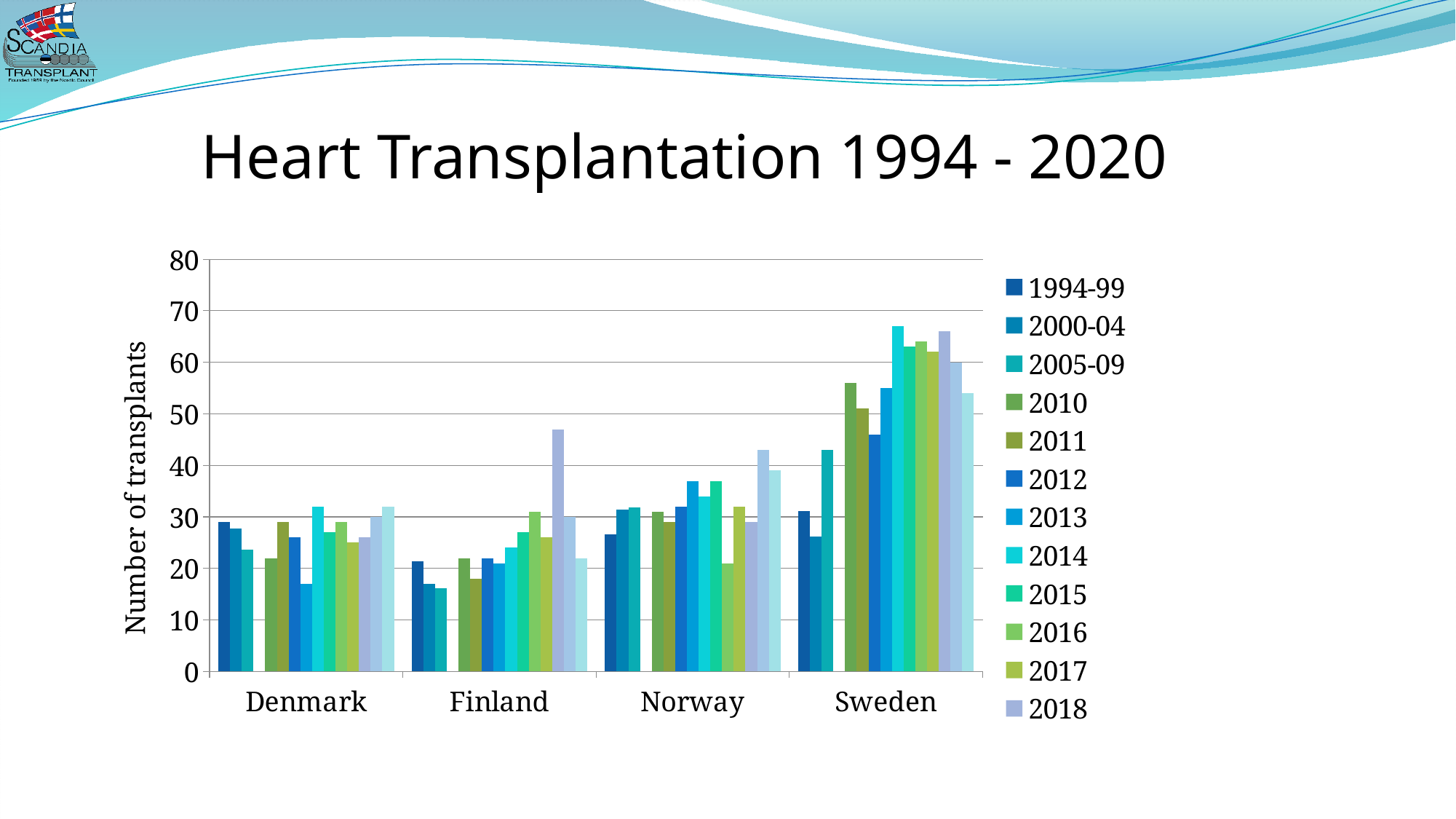
Which country has the lowest bars overall in the chart? Finland Is the value for Denmark in 2012 greater or less than 20? greater Which is larger, the 2010 value for Sweden or the 2010 value for Denmark? Sweden How many countries are shown on the x axis of the chart? 4 What is the label on the y axis of the chart? Number of transplants Is the value for Finland in 2018 greater or less than 40? greater Is the value for Sweden in 2014 greater or less than 60? greater Which is larger, the 2014 value for Norway or the 2014 value for Finland? Norway What kind of chart is shown on the slide? bar chart How many series does the chart's legend list? 12 Which country has the highest number of heart transplants in the chart? Sweden